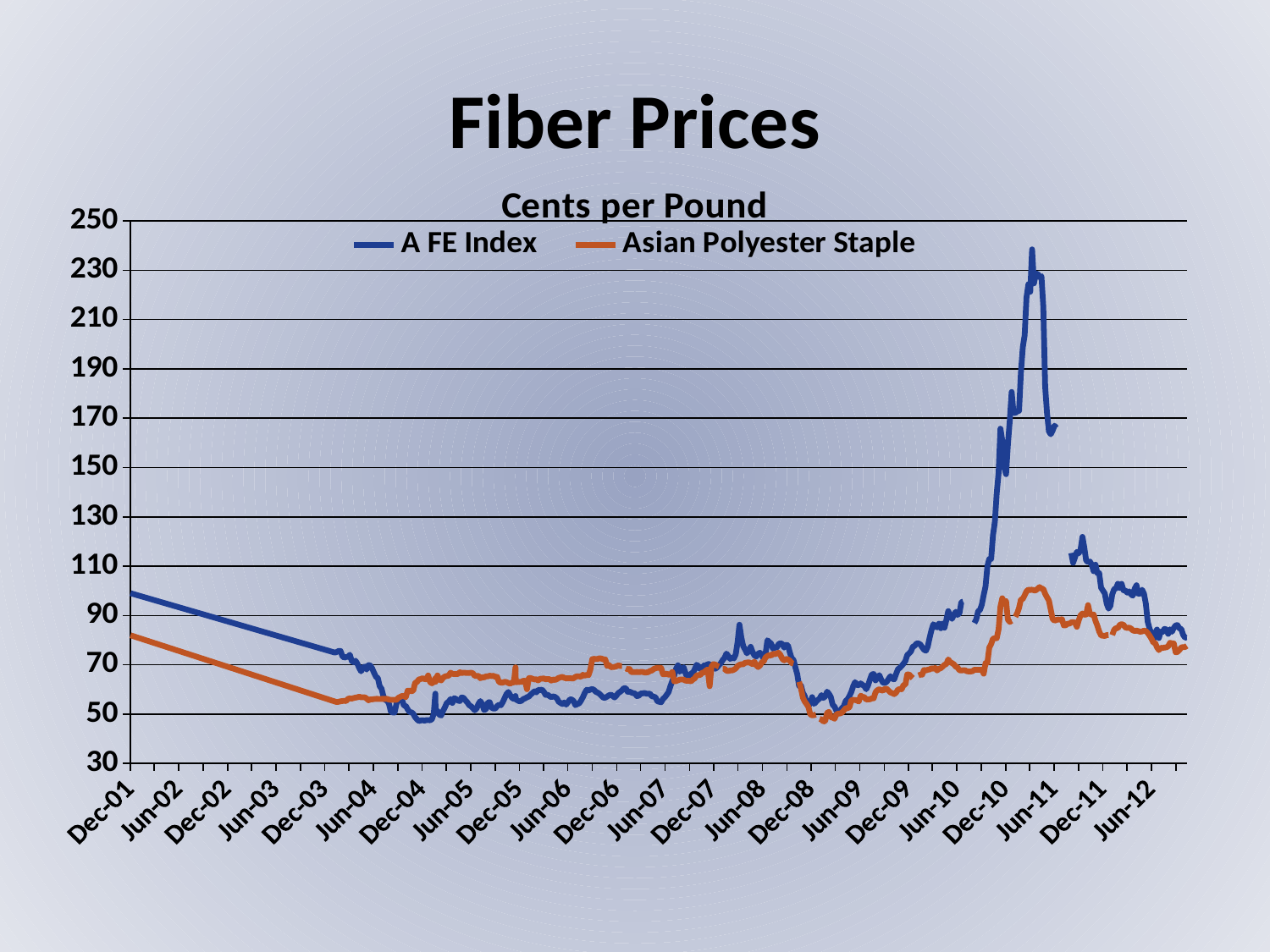
Around Jun-11, which series has the higher value, A FE Index or Asian Polyester Staple? A FE Index Is the value of the A FE Index at Dec-01 greater or less than 90? greater What are the two series named in the legend? A FE Index and Asian Polyester Staple What is the title shown above the chart? Cents per Pound What kind of chart is shown on the slide? line chart Does the A FE Index rise or fall between Dec-01 and Dec-03? fall Is the peak value of Asian Polyester Staple greater or less than 110? less Is the peak value of the A FE Index greater or less than 210? greater How many series does the legend list? 2 Which series reaches the highest value anywhere on the chart? A FE Index At Dec-01, which series has the higher value, A FE Index or Asian Polyester Staple? A FE Index